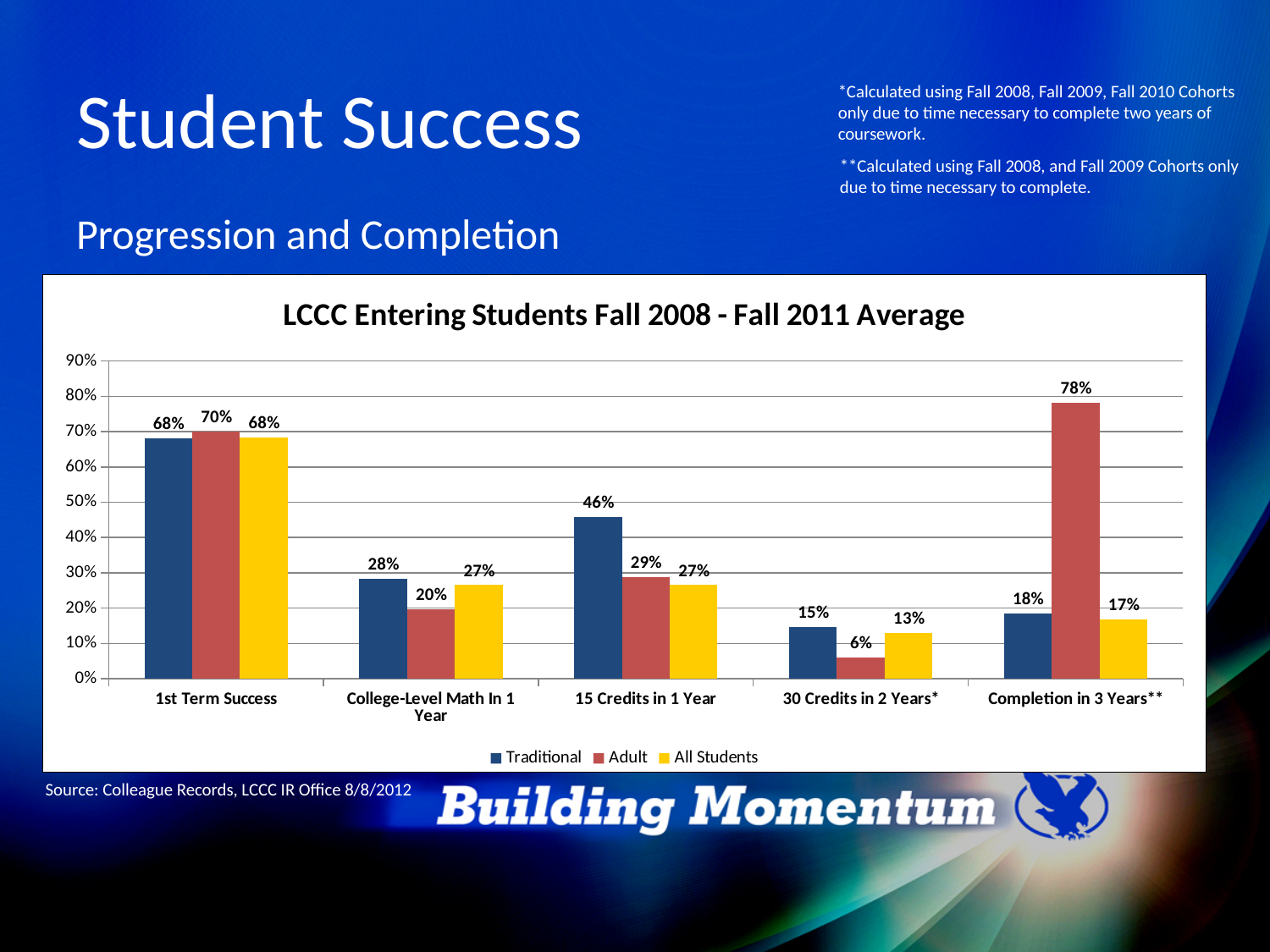
Which is larger for Completion in 3 Years**: the Traditional value or the Adult value? Adult What is the title of the chart? LCCC Entering Students Fall 2008 - Fall 2011 Average What is the All Students value for 30 Credits in 2 Years*? 13% How many series does the legend list? 3 What kind of chart is shown on the slide? bar chart What is the difference between the Traditional and Adult values for College-Level Math In 1 Year? 8% Which category has the highest Traditional value? 1st Term Success What is the Traditional value for 15 Credits in 1 Year? 46% What is the Adult value for Completion in 3 Years**? 78% How many categories are shown on the x axis? 5 Is the Adult value for 15 Credits in 1 Year greater or less than 40%? less Which category has the lowest Adult value? 30 Credits in 2 Years*